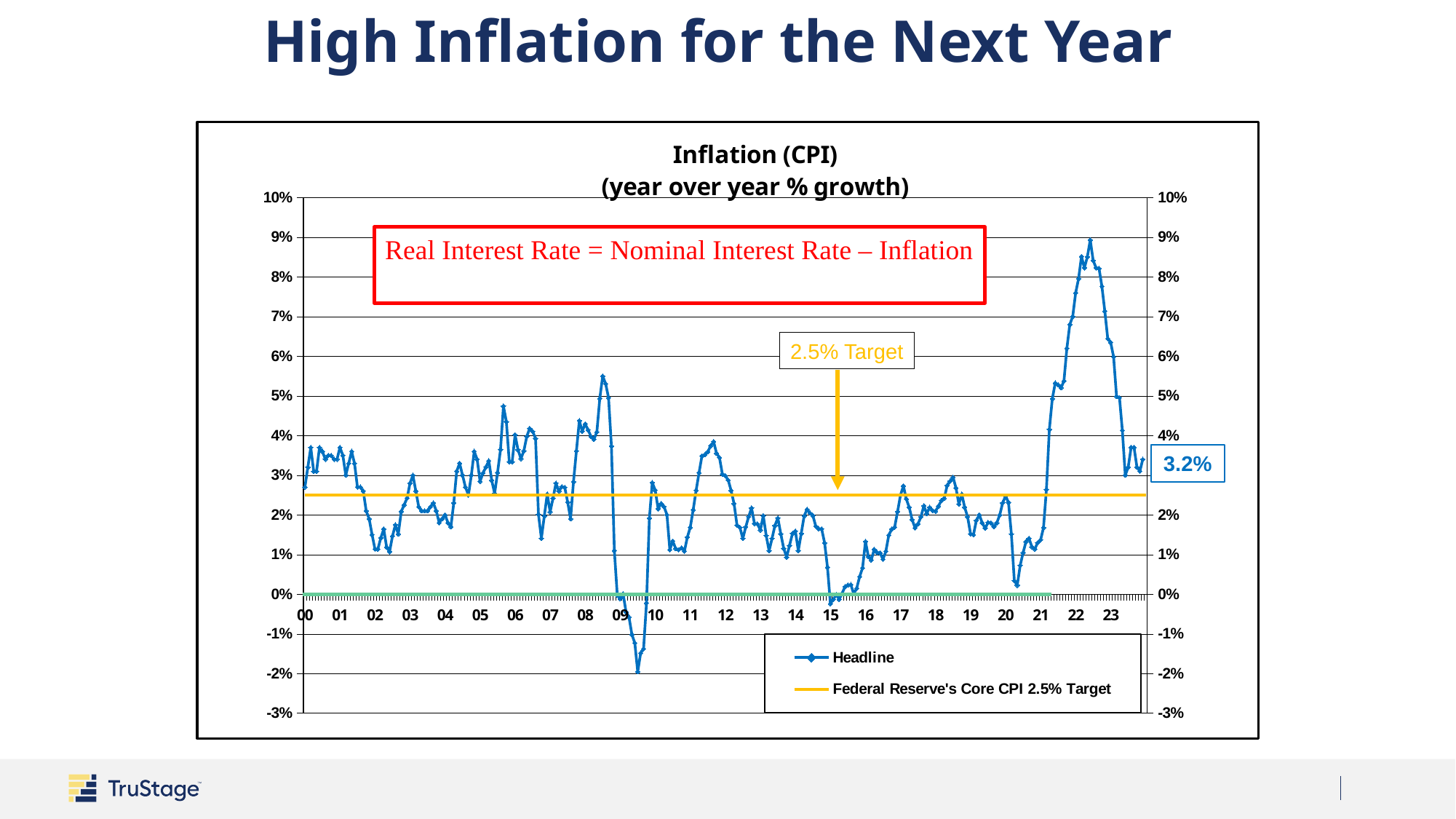
Does the Headline series rise or fall between 2021 and mid-2022? rise In which year does the Headline series reach its lowest value? 09 What is the Federal Reserve's Core CPI target shown on the chart? 2.5% What kind of chart is shown on the slide? line chart Is the lowest Headline inflation value in 2009 greater or less than -1%? less How many series does the chart's legend list? 2 Is the peak Headline inflation value in 2022 greater or less than 8%? greater By how many percentage points does the latest Headline value of 3.2% exceed the 2.5% target? 0.7 percentage points In which year does the Headline series reach its highest value? 22 Which is larger: the latest Headline value of 3.2% or the Federal Reserve's 2.5% target? the latest Headline value (3.2%) What is the most recent Headline inflation value labeled on the chart? 3.2% What is the title of the chart? Inflation (CPI) (year over year % growth)